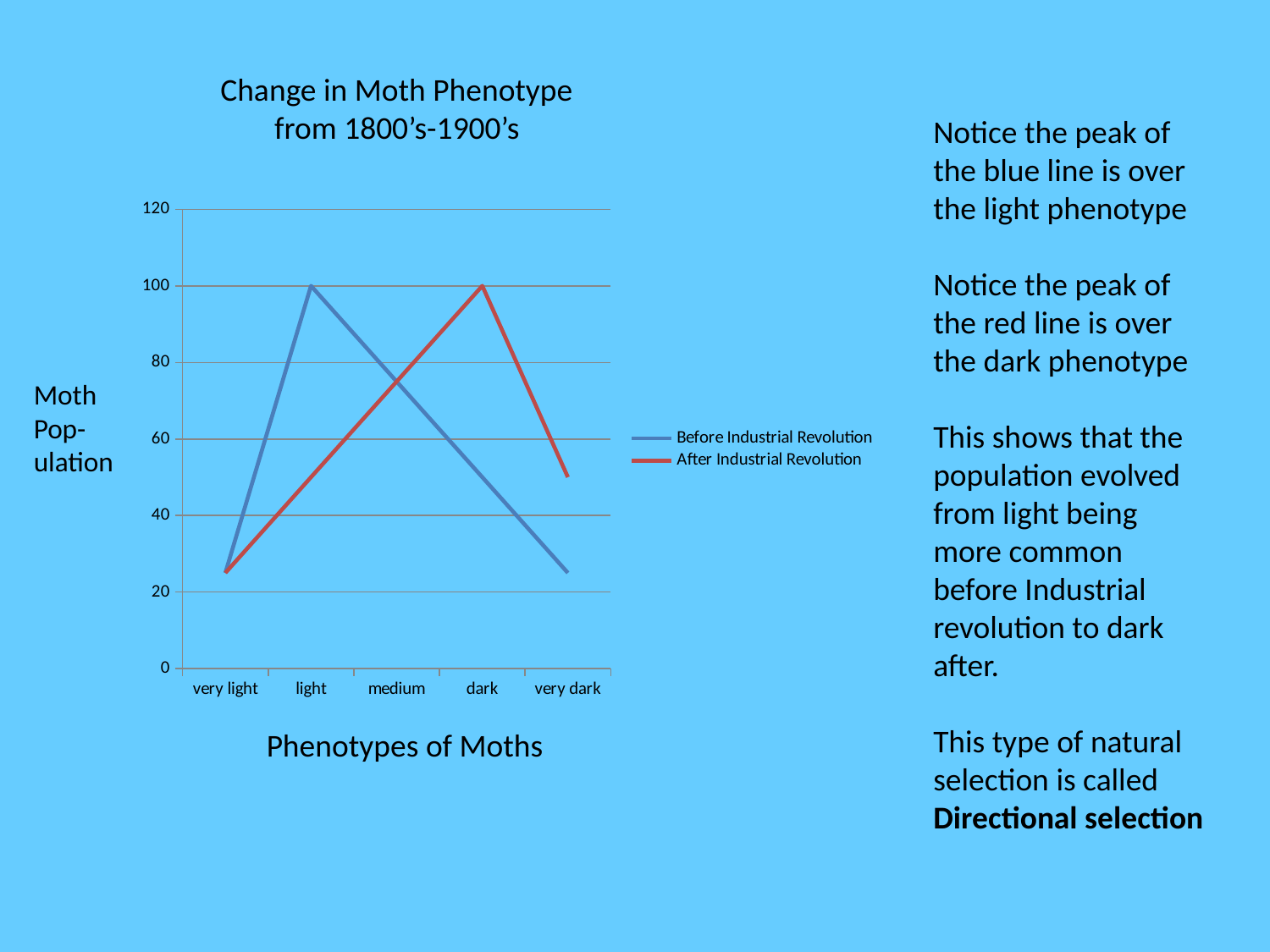
What kind of chart is shown on the slide? line chart How many phenotype categories are shown on the x axis? 5 What is the value of the Before Industrial Revolution line at the light phenotype? 100 What is the value of the After Industrial Revolution line at the dark phenotype? 100 How many series does the legend list? 2 Which phenotype has the highest value for the Before Industrial Revolution series? light Is the value of the Before Industrial Revolution line at very dark greater or less than 40? less Which phenotype has the highest value for the After Industrial Revolution series? dark Does the Before Industrial Revolution line rise or fall from light to very dark? fall Is the value of the After Industrial Revolution line at very dark greater or less than 40? greater Which phenotype has the lowest value for the After Industrial Revolution series? very light At the dark phenotype, which series has the larger value, Before Industrial Revolution or After Industrial Revolution? After Industrial Revolution